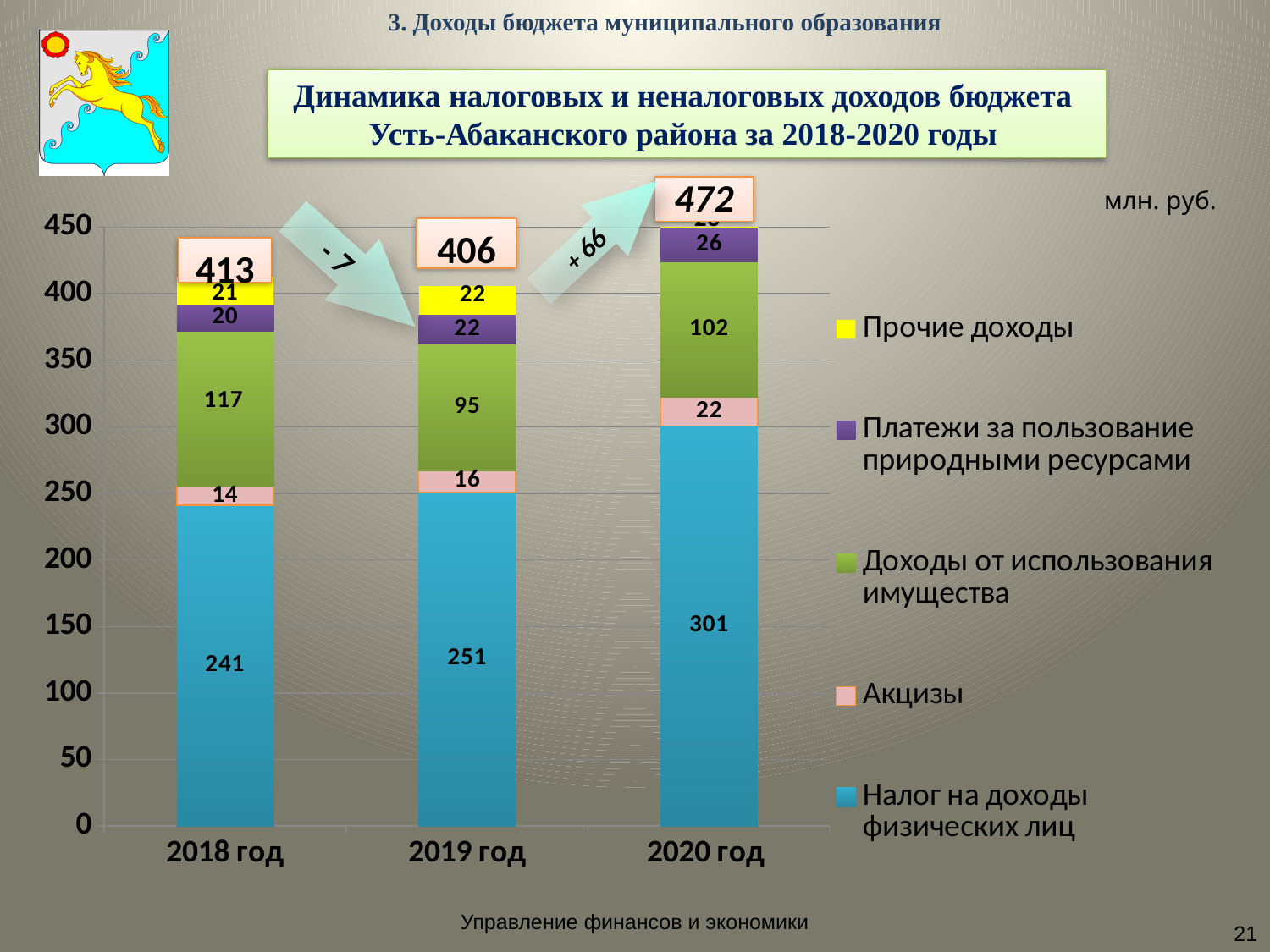
What is the value of Платежи за пользование природными ресурсами for 2020 год? 26 What is the difference between the Налог на доходы физических лиц values for 2020 год and 2018 год? 60 How many series does the legend list? 5 What is the total of the stacked bar for 2020 год? 472 Which year has the lowest total bar? 2019 год What is the value of Налог на доходы физических лиц for 2018 год? 241 Does the value of Налог на доходы физических лиц rise or fall from 2018 год to 2020 год? rises How many years are shown on the x axis? 3 What is the value of Акцизы for 2020 год? 22 Which year has the highest total bar? 2020 год What is the value of Доходы от использования имущества for 2019 год? 95 Which year has the larger value for Доходы от использования имущества, 2018 год or 2019 год? 2018 год